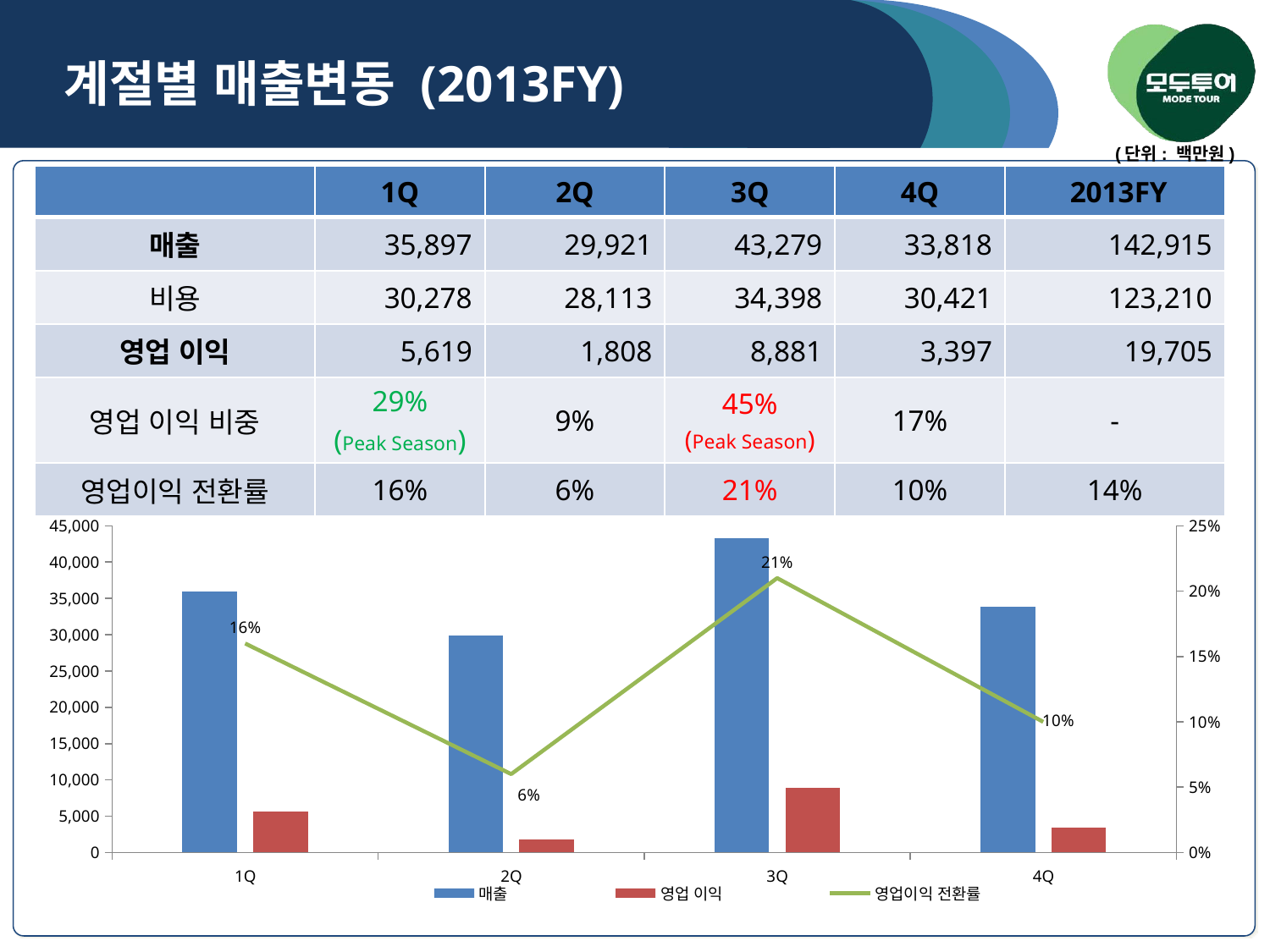
What is the difference between the 영업이익 전환률 labels for 3Q and 2Q? 15% In which quarter is the 영업 이익 bar the lowest? 2Q Does the 영업이익 전환률 line rise or fall from 1Q to 2Q? fall Which quarter has the larger 매출 bar, 1Q or 2Q? 1Q Is the 매출 value for 3Q greater or less than 40,000? greater What is the 영업이익 전환률 value labelled on the line for 3Q? 21% What is the 영업이익 전환률 value labelled on the line for 1Q? 16% How many quarters are shown on the x axis of the chart? 4 In which quarter is the 매출 bar the highest? 3Q Is the 영업 이익 value for 2Q greater or less than 5,000? less How many series does the chart legend list? 3 What kind of chart is shown at the bottom of the slide? A combined bar and line chart